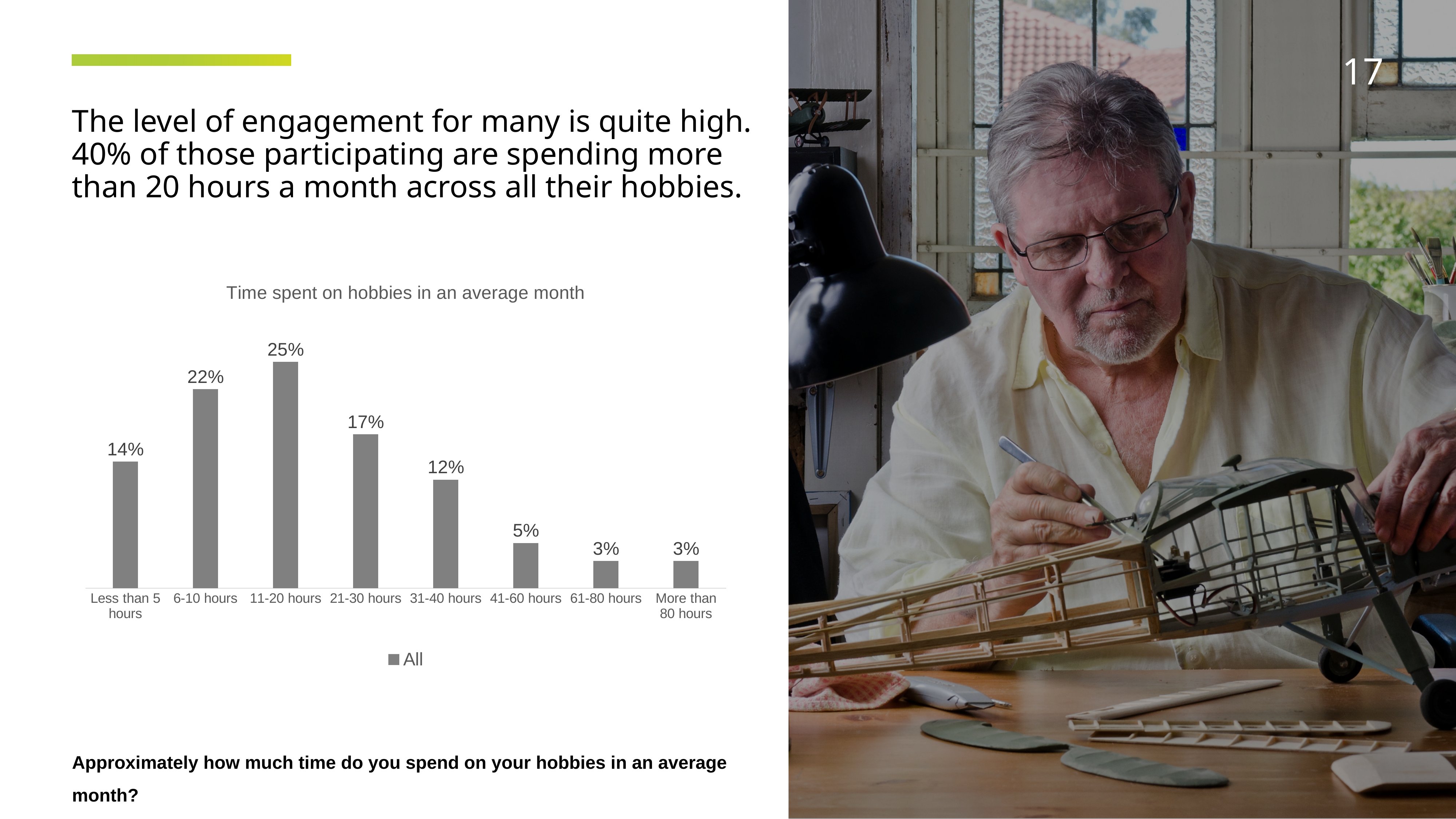
How many series does the legend list? 1 What is the difference between the values for 6-10 hours and 21-30 hours? 5% What is the name of the series in the legend? All Which is larger, the value for 41-60 hours or the value for 31-40 hours? 31-40 hours How many categories are shown on the x axis? 8 What percentage spend 31-40 hours on hobbies in an average month? 12% What kind of chart is shown on the slide? Bar chart What is the value for the 'Less than 5 hours' category? 14% What percentage of respondents spend 11-20 hours on hobbies in an average month? 25% What is the title of the chart? Time spent on hobbies in an average month Do the values rise or fall from 11-20 hours to More than 80 hours? Fall Which category has the highest value? 11-20 hours